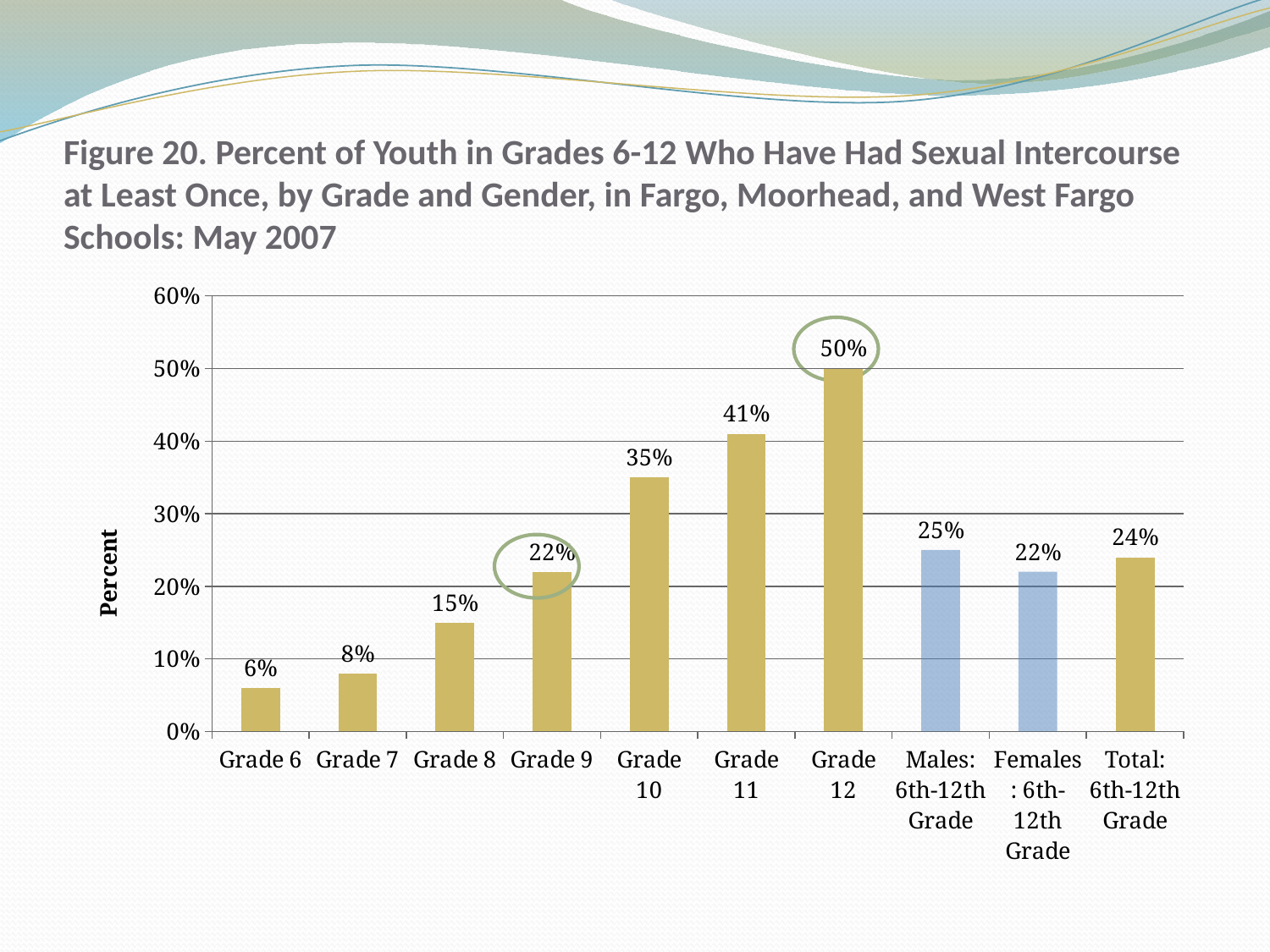
What is the difference between the values for Grade 12 and Grade 11? 9% What is the difference between the values for Males: 6th-12th Grade and Females: 6th-12th Grade? 3% Which category has the lowest value? Grade 6 What is the value for Total: 6th-12th Grade? 24% How many categories are shown on the x axis? 10 What is the value for Males: 6th-12th Grade? 25% What kind of chart is this? Bar chart Which is larger, the value for Grade 10 or the value for Grade 9? Grade 10 Which category has the highest value? Grade 12 Do the values rise or fall from Grade 6 to Grade 12? Rise What is the value for Grade 12? 50% What is the value for Grade 6? 6%